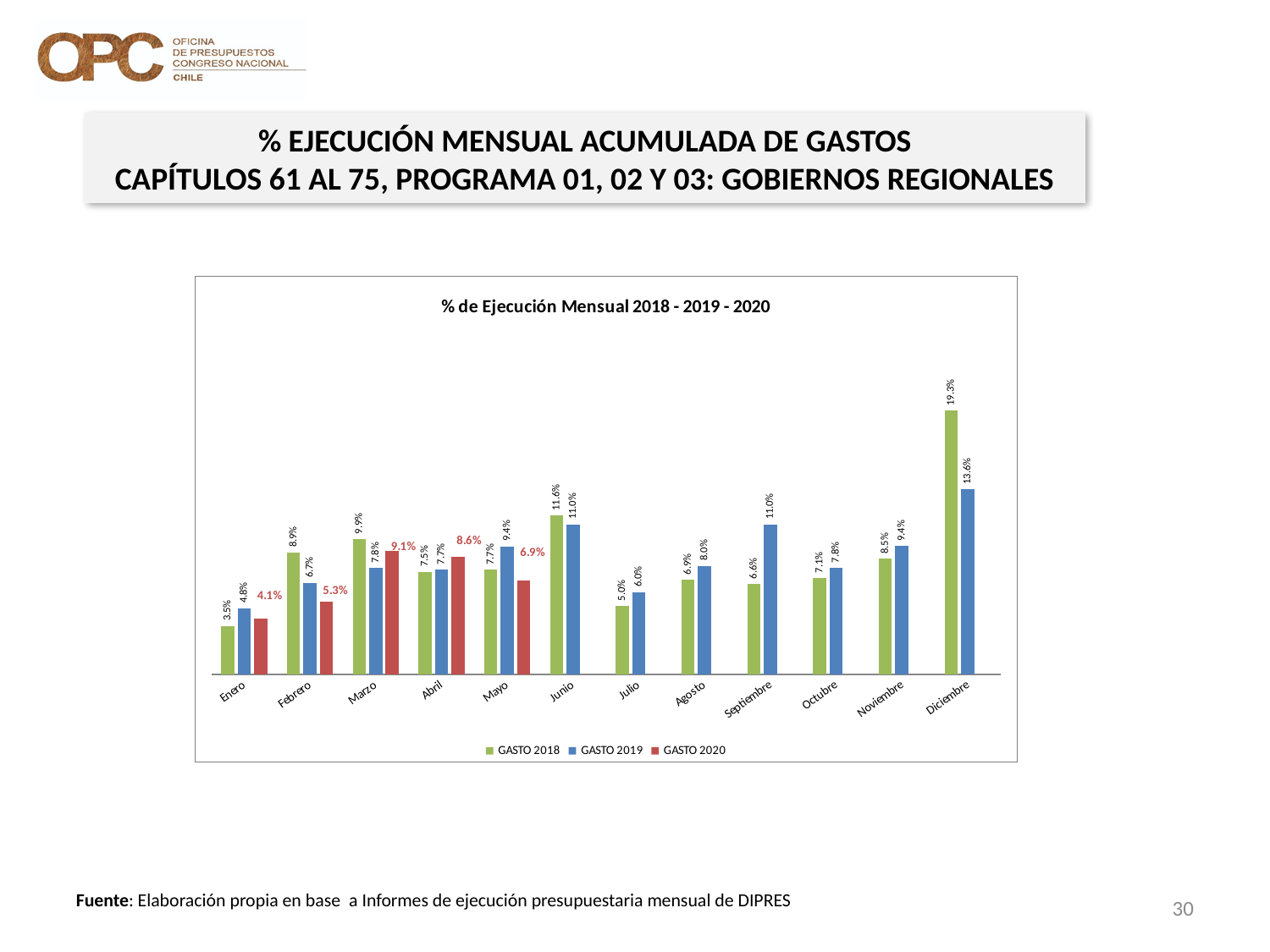
How many series does the legend list? 3 What is the difference between GASTO 2018 and GASTO 2019 in Diciembre? 5.7% Which month has the highest value for GASTO 2019? Diciembre What is the value for GASTO 2018 in Diciembre? 19.3% What is the difference between GASTO 2019 and GASTO 2020 in Mayo? 2.5% What type of chart is shown on the slide? Bar chart What is the value for GASTO 2020 in Abril? 8.6% Which month has the lowest value for GASTO 2018? Enero What is the title of the chart? % de Ejecución Mensual 2018 - 2019 - 2020 How many months are shown on the x axis? 12 Which is larger in Febrero, GASTO 2018 or GASTO 2020? GASTO 2018 What is the value for GASTO 2019 in Septiembre? 11.0%